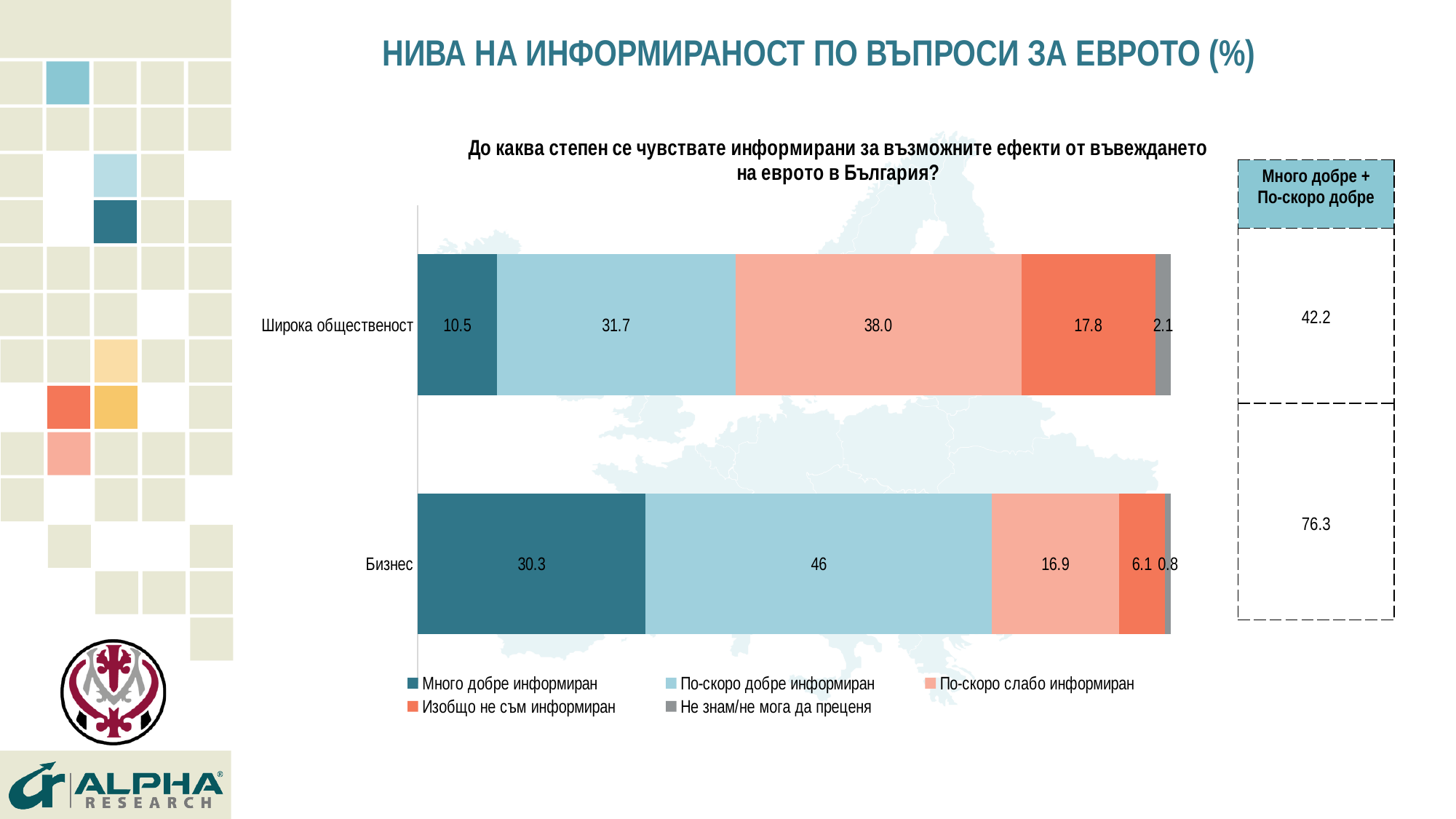
Which category has the larger 'Много добре информиран' value, 'Широка общественост' or 'Бизнес'? Бизнес What is the value of 'Изобщо не съм информиран' for 'Широка общественост'? 17.8 What is the value of 'Много добре информиран' for 'Широка общественост'? 10.5 Which segment is the largest in the 'Широка общественост' bar? По-скоро слабо информиран What is the combined 'Много добре + По-скоро добре' value shown for 'Бизнес' in the box to the right of the chart? 76.3 What is the value of 'Не знам/не мога да преценя' for 'Бизнес'? 0.8 What type of chart is shown on the slide? Stacked bar chart Which segment is the smallest in the 'Бизнес' bar? Не знам/не мога да преценя What is the difference between the 'По-скоро добре информиран' values for 'Бизнес' and 'Широка общественост'? 14.3 How many series does the legend list? 5 What is the value of 'По-скоро добре информиран' for 'Бизнес'? 46 How many categories are plotted on the chart? 2